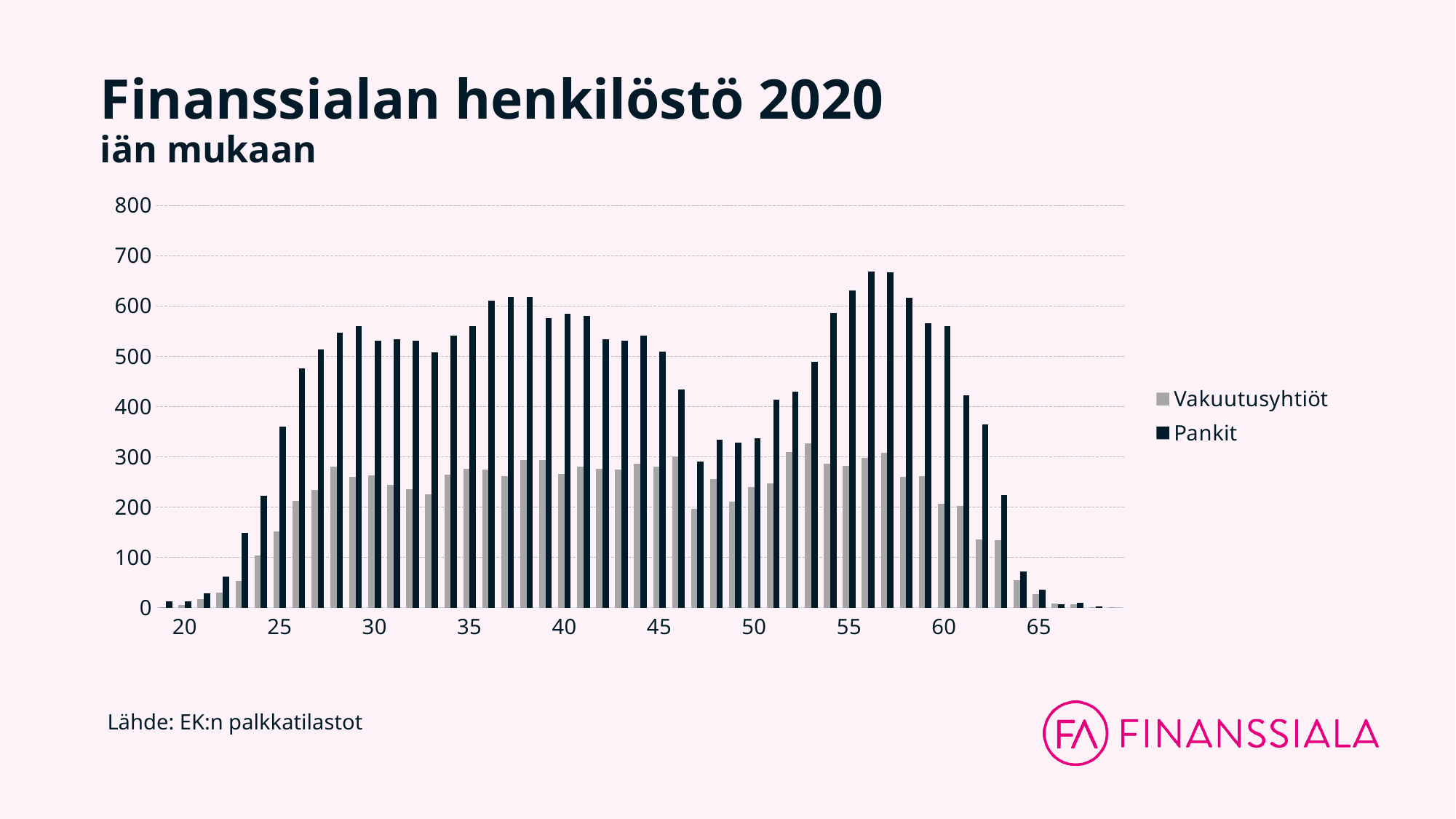
For the Pankit series, which age has the larger value, 30 or 50? 30 What are the two series named in the legend? Vakuutusyhtiöt and Pankit Is the Vakuutusyhtiöt value at age 40 greater or less than 300? less What kind of chart is shown on the slide? bar chart Is the Pankit value at age 30 greater or less than 500? greater Is the Pankit value at age 25 greater or less than 300? greater Do the Pankit values rise or fall from age 60 to age 65? fall At age 35, which series has the larger value, Pankit or Vakuutusyhtiöt? Pankit How many series does the legend list? 2 What is the source given below the chart? EK:n palkkatilastot